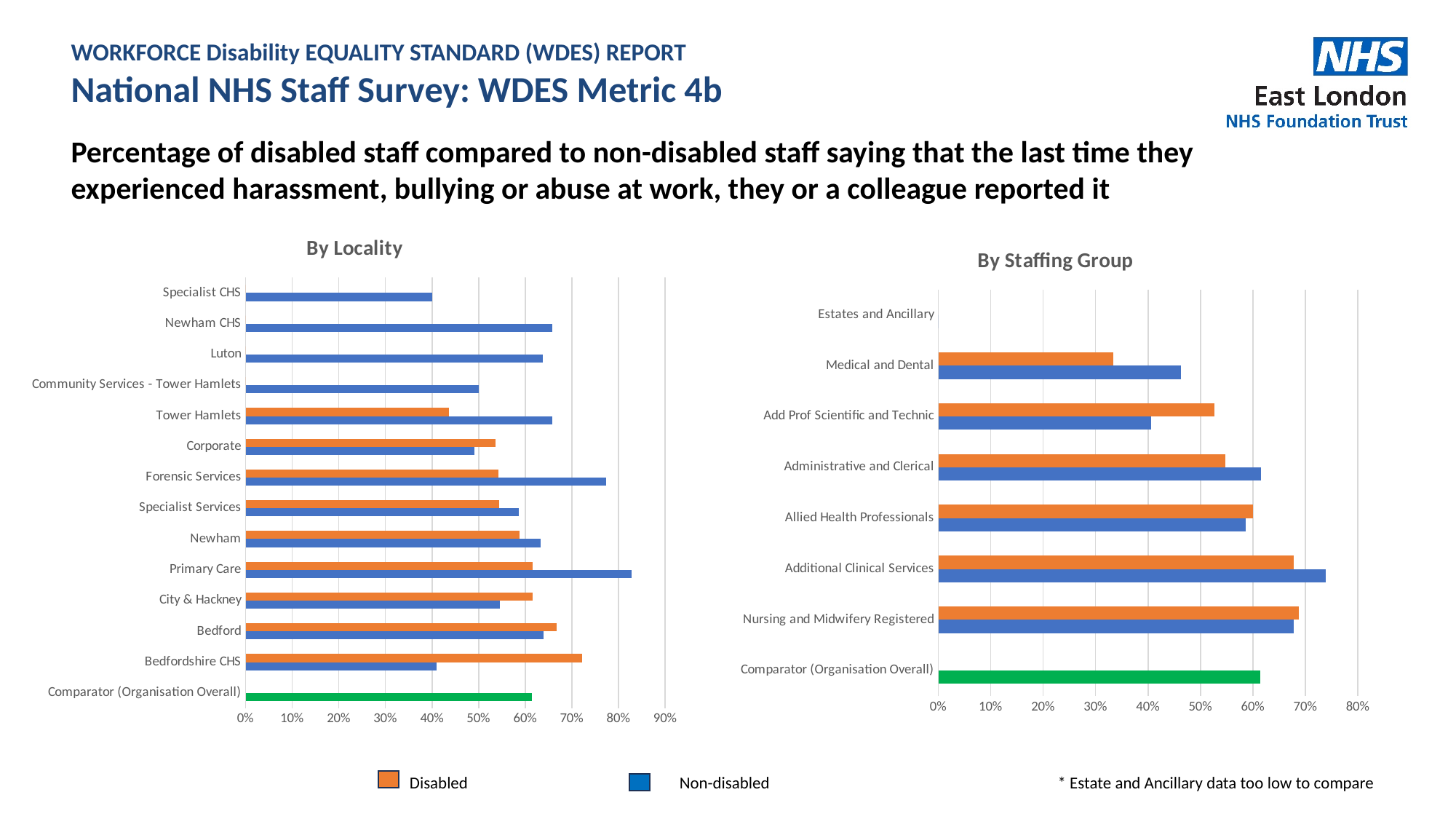
In the 'By Locality' chart, for Forensic Services, which is larger: the Disabled value or the Non-disabled value? Non-disabled In the 'By Locality' chart, which locality has the highest Non-disabled value? Primary Care In the 'By Locality' chart, is the Non-disabled value for Primary Care greater or less than 80%? greater How many series does the legend list? 2 In the 'By Staffing Group' chart, how many categories are shown on the vertical axis? 8 In the 'By Staffing Group' chart, for Add Prof Scientific and Technic, which is larger: the Disabled value or the Non-disabled value? Disabled What kind of chart is the 'By Locality' chart? bar chart In the 'By Staffing Group' chart, which category has no bars plotted? Estates and Ancillary In the 'By Staffing Group' chart, which staffing group has the lowest Disabled value among those with bars? Medical and Dental In the 'By Staffing Group' chart, is the Disabled value for Medical and Dental greater or less than 40%? less In the 'By Locality' chart, is the Disabled value for Bedfordshire CHS greater or less than 70%? greater In the 'By Locality' chart, how many categories are shown on the vertical axis? 14